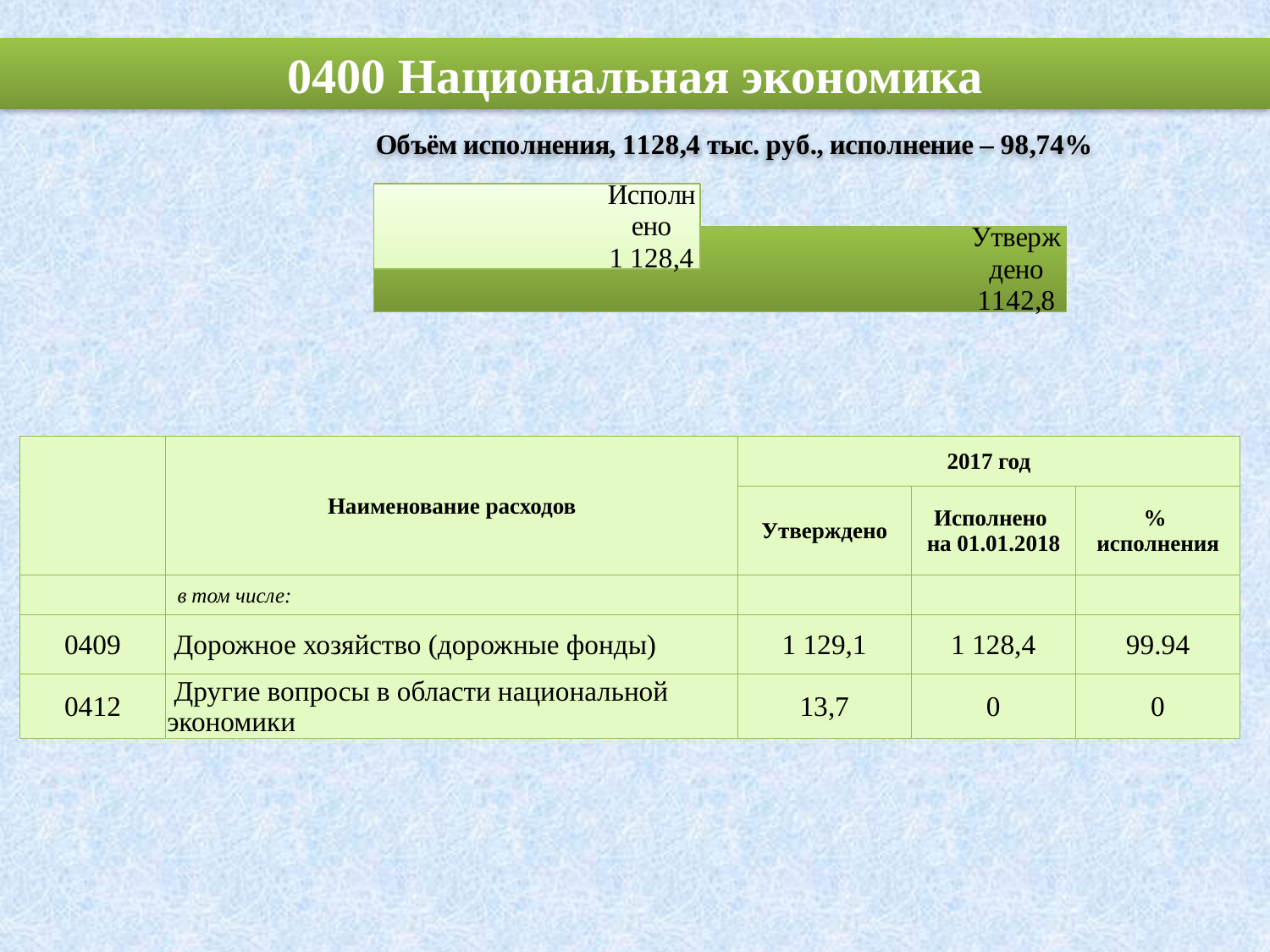
Which bar in the chart has the higher value? Утверждено What is the difference between the Утверждено and Исполнено values in the chart? 14,4 Which bar in the chart is positioned above the other? Исполнено What type of chart is shown on the slide? bar chart Is the value for Утверждено larger or smaller than the value for Исполнено in the chart? larger How many bars are plotted in the chart? 2 Which bar in the chart has the lower value? Исполнено What value is shown for Исполнено in the bar chart? 1 128,4 What value is shown for Утверждено in the bar chart? 1142,8 Which bar in the chart is drawn in the darker green colour? Утверждено